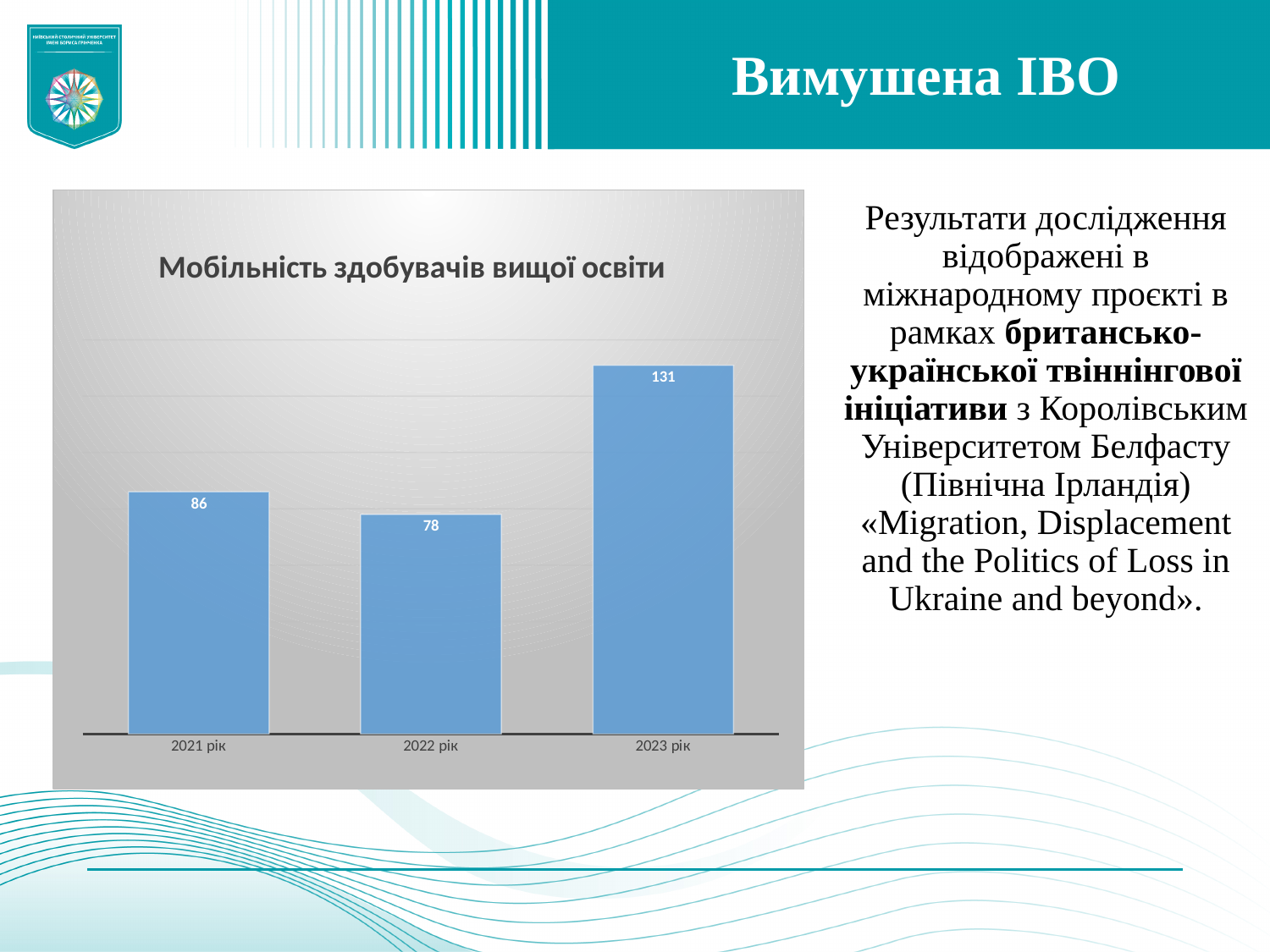
Which year has the lowest value? 2022 рік What is the value for 2023 рік? 131 What is the title of the chart? Мобільність здобувачів вищої освіти What is the value for 2022 рік? 78 What is the value for 2021 рік? 86 What kind of chart is shown on the slide? bar chart Which is larger, the value for 2021 рік or the value for 2022 рік? 2021 рік Which year has the highest value? 2023 рік How many categories are shown on the x axis? 3 What is the difference between the values for 2021 рік and 2022 рік? 8 What colour are the bars in the chart? blue What is the difference between the values for 2023 рік and 2022 рік? 53